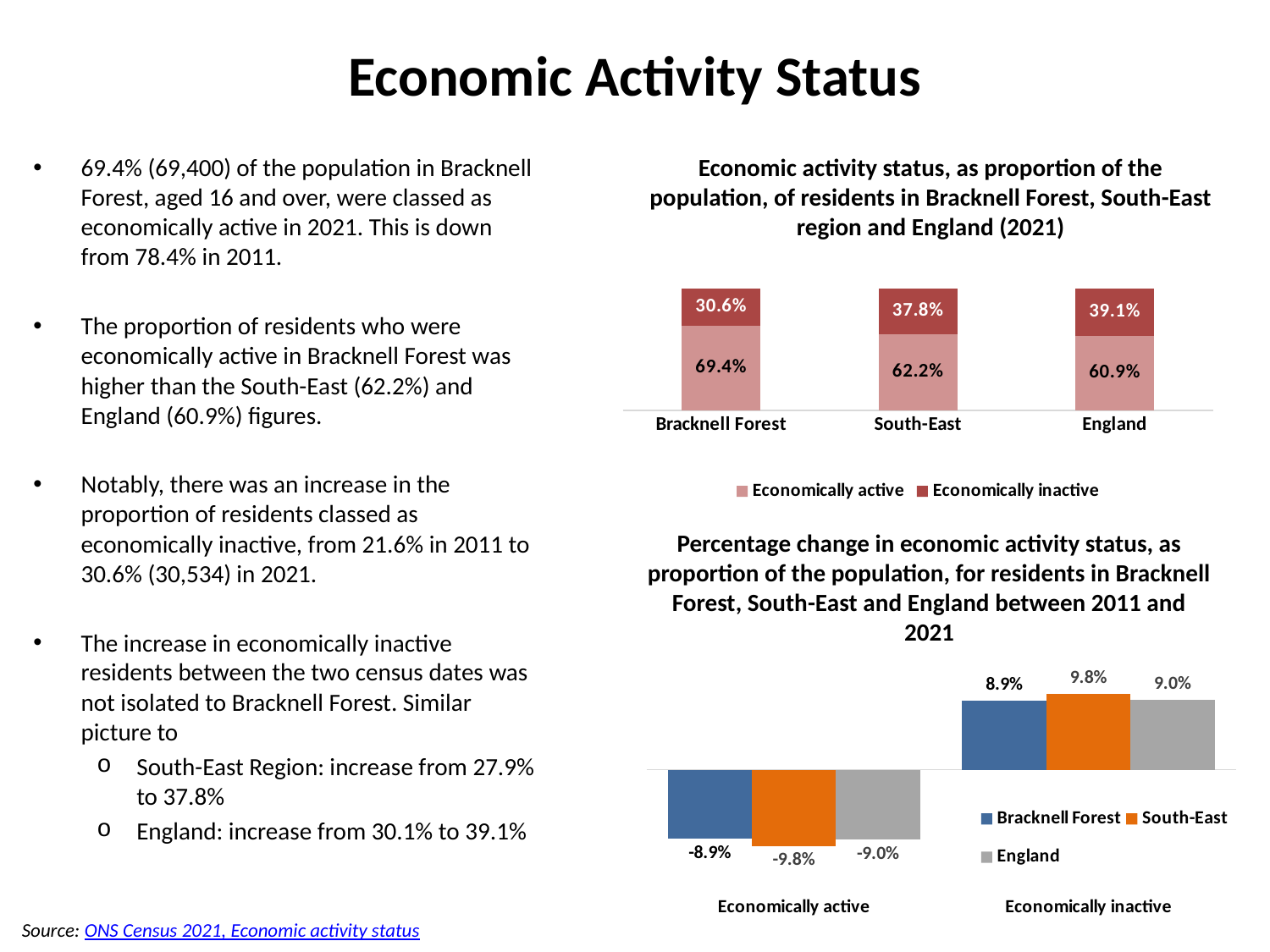
What kind of chart is the bottom chart (Percentage change in economic activity status)? Bar chart In the bottom chart (Percentage change in economic activity status), what is the value for Bracknell Forest in the Economically active category? -8.9% In the top chart (Economic activity status, as proportion of the population), which area has the lowest economically active proportion? England In the top chart (Economic activity status, as proportion of the population), what is the total of the stacked bar for South-East? 100% In the top chart (Economic activity status, as proportion of the population), what is the difference between the economically active values for Bracknell Forest and South-East? 7.2% In the top chart (Economic activity status, as proportion of the population), what is the economically active value for Bracknell Forest? 69.4% In the bottom chart (Percentage change in economic activity status), which area has the largest increase in the Economically inactive category? South-East In the bottom chart (Percentage change in economic activity status), how many categories are shown on the x axis? 2 In the top chart (Economic activity status, as proportion of the population), how many series does the legend list? 2 In the top chart (Economic activity status, as proportion of the population), which area has the highest economically inactive proportion? England In the top chart (Economic activity status, as proportion of the population), what is the economically inactive value for England? 39.1% In the bottom chart (Percentage change in economic activity status), what is the value for South-East in the Economically inactive category? 9.8%